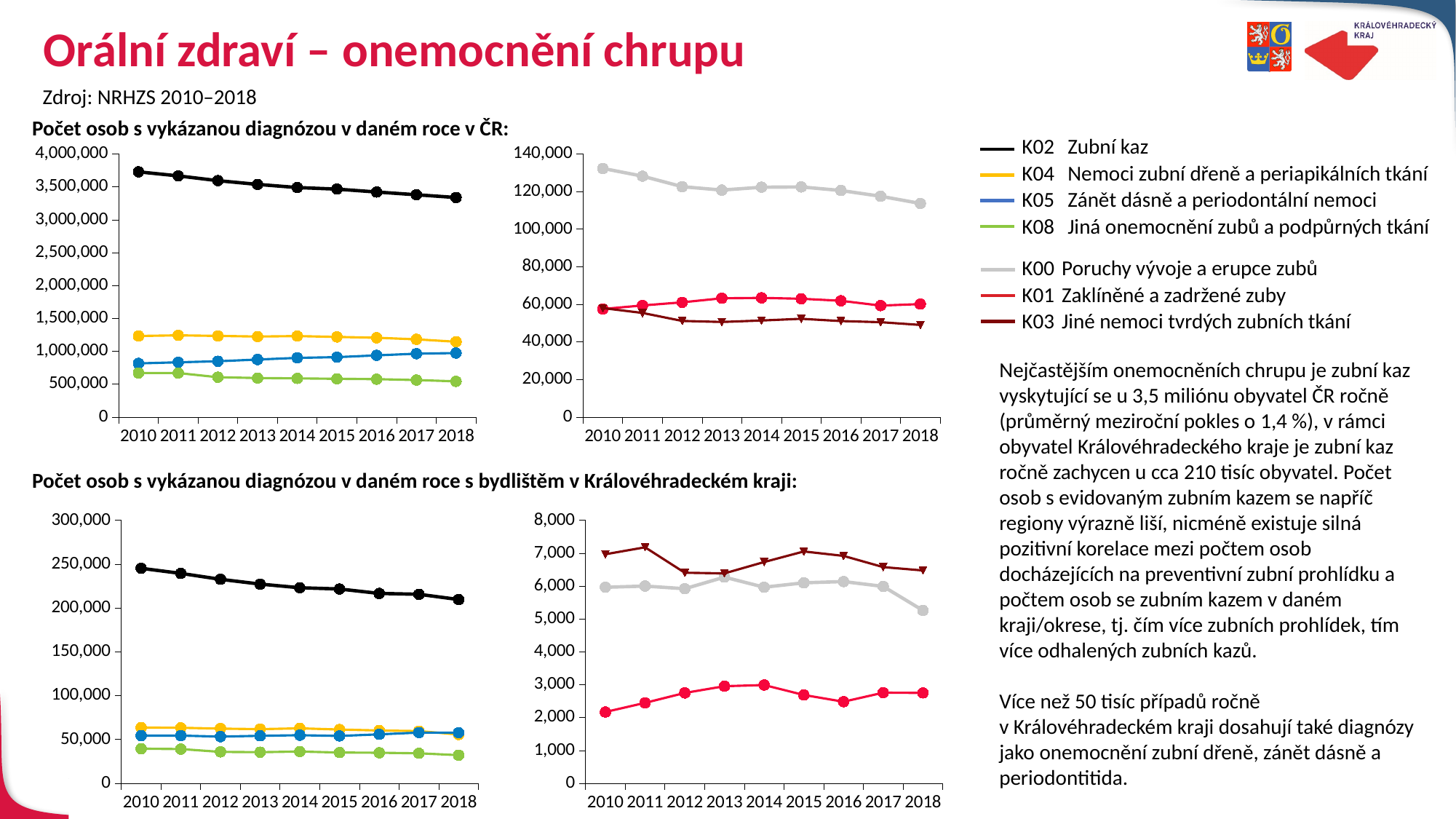
How many series does the legend on the slide list in total? 7 In the top-left chart for ČR, which series has the highest values? K02 Zubní kaz In the top-left chart for ČR, is the value for K02 Zubní kaz in 2018 greater or less than 3,500,000? less In the top-left chart for ČR, how many years are shown on the x axis? 9 In the bottom-left chart for Královéhradecký kraj, is the value for K02 Zubní kaz in 2010 greater or less than 200,000? greater In the top-left chart for ČR, does the value for K02 Zubní kaz rise or fall from 2010 to 2018? fall In the top-left chart for ČR, which series has the lowest values? K08 Jiná onemocnění zubů a podpůrných tkání What kind of chart is the top-left chart (Počet osob s vykázanou diagnózou v daném roce v ČR)? line chart In the bottom-right chart for Královéhradecký kraj, which is larger in 2010: K03 Jiné nemoci tvrdých zubních tkání or K00 Poruchy vývoje a erupce zubů? K03 Jiné nemoci tvrdých zubních tkání In the top-left chart for ČR, is the value for K02 Zubní kaz in 2010 greater or less than 3,500,000? greater